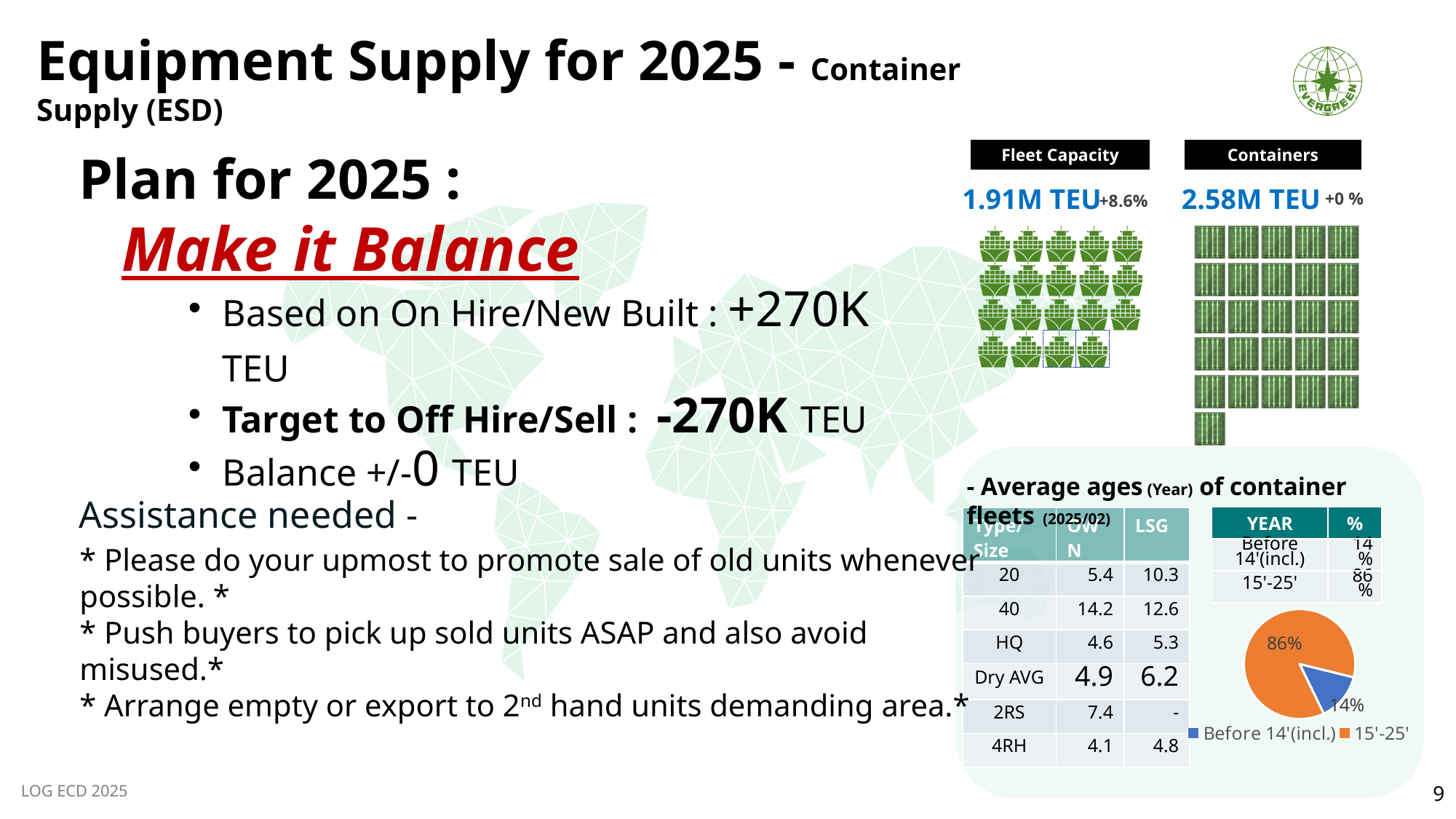
In the pie chart, which is larger: the 15'-25' slice or the Before 14'(incl.) slice? 15'-25' What kind of chart is shown at the bottom right of the slide? pie chart In the pie chart, what colour is the 15'-25' slice? orange How many slices does the pie chart have? 2 In the pie chart, what colour is the Before 14'(incl.) slice? blue In the pie chart, what is the difference in percentage points between the 15'-25' slice and the Before 14'(incl.) slice? 72 In the pie chart, what share is shown for the Before 14'(incl.) slice? 14% In the pie chart, what share is shown for the 15'-25' slice? 86% In the pie chart, which slice is the largest? 15'-25' In the pie chart, which slice is the smallest? Before 14'(incl.) How many entries does the pie chart's legend list? 2